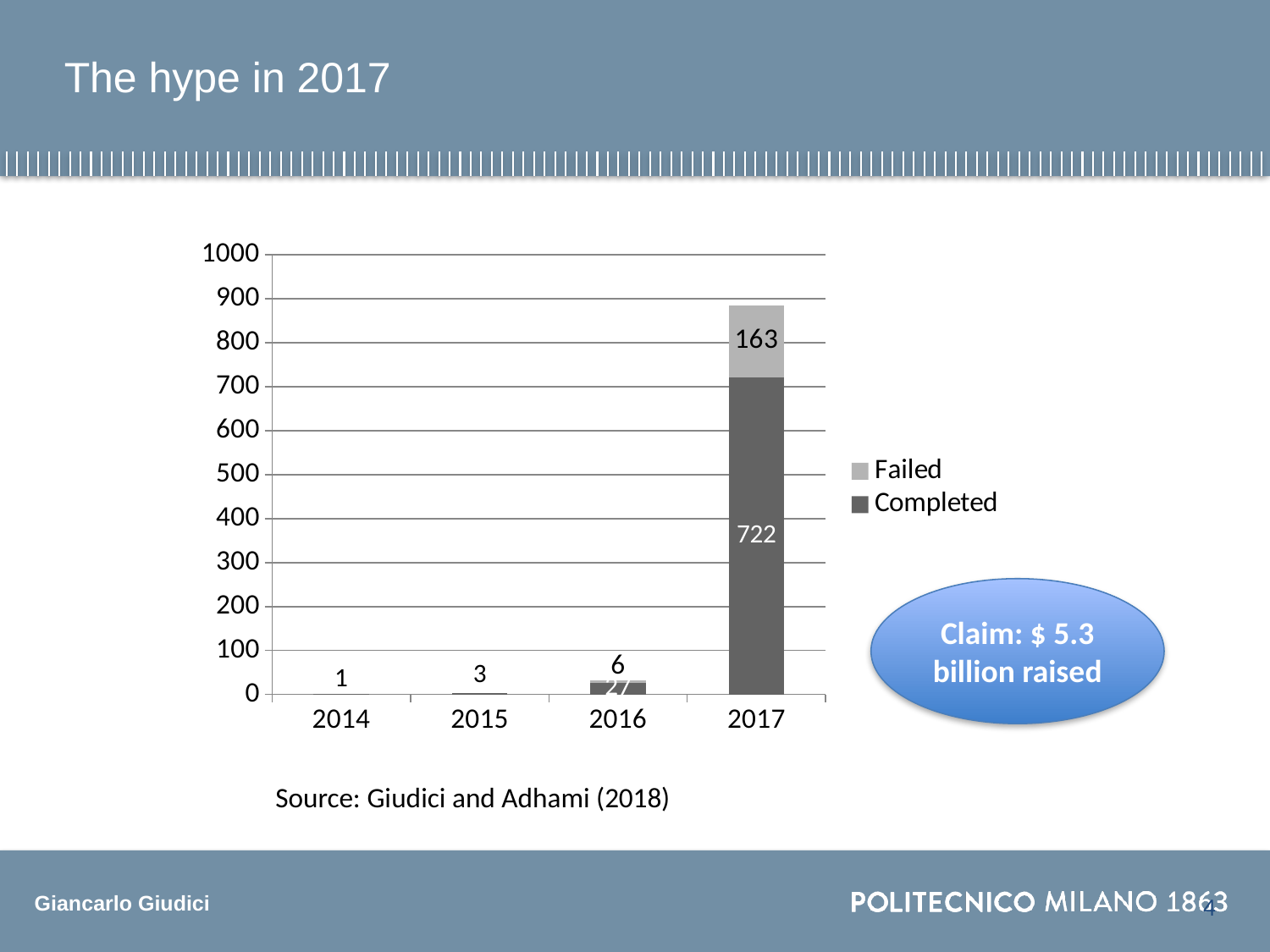
Which year has the highest total bar? 2017 What is the value for Failed in 2017? 163 Is the total value for 2017 greater or less than 800? greater What kind of chart is shown on the slide? Stacked bar chart Do the total values rise or fall from 2014 to 2017? Rise What is the value for Completed in 2017? 722 How many series does the legend list? 2 How many years are shown on the x axis? 4 What is the difference between Completed and Failed in 2017? 559 What are the two entries in the chart legend? Failed and Completed What is the total of the stacked bar for 2017? 885 In 2017, which is larger, Completed or Failed? Completed